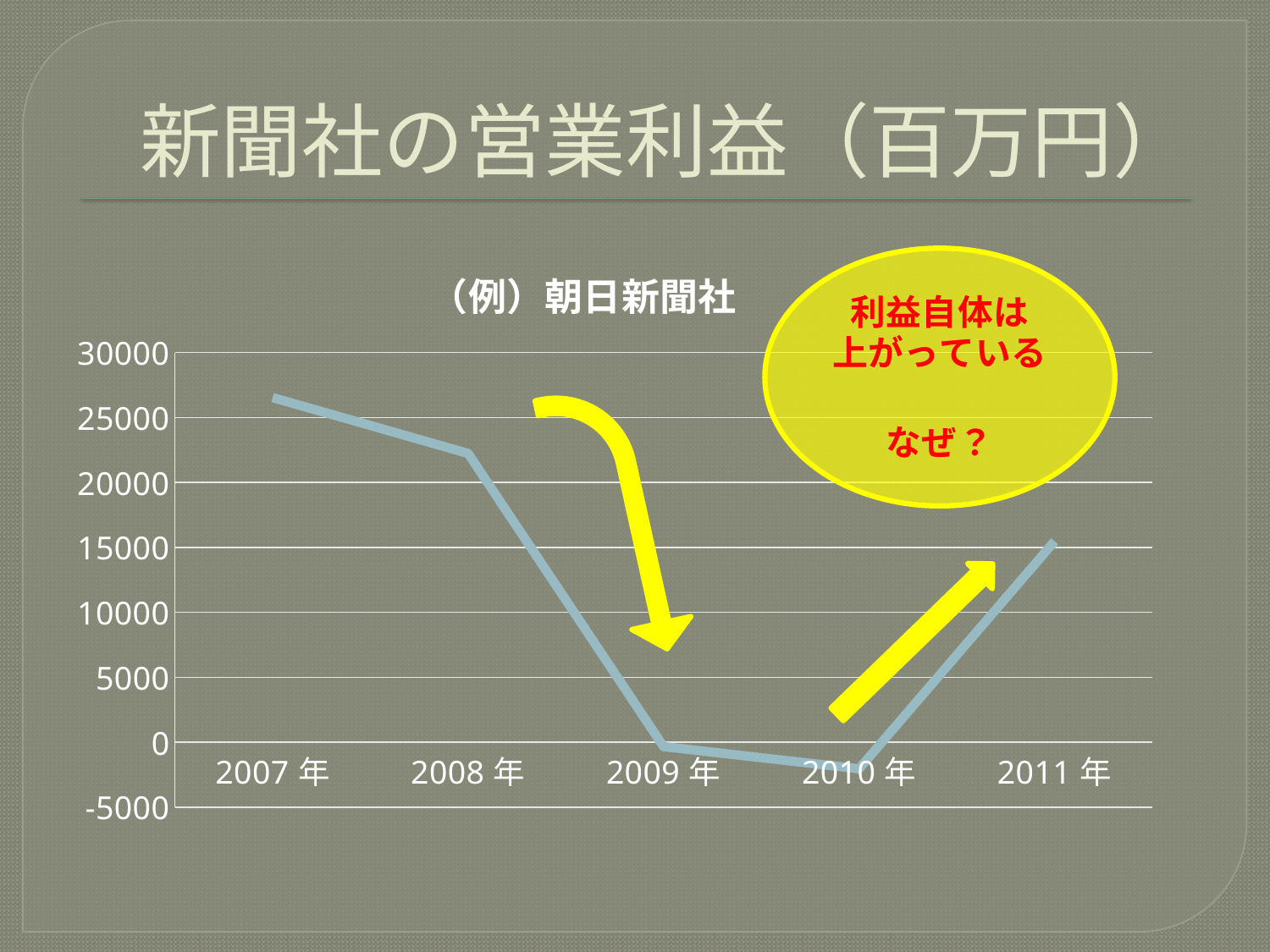
Is the value for 2011年 greater or less than 10000? greater Is the value for 2008年 greater or less than 20000? greater Which is larger, the value for 2007年 or the value for 2008年? 2007年 Which year has the highest operating profit in the chart? 2007年 Is the value for 2009年 greater or less than 5000? less What is the title of the chart? （例）朝日新聞社 What kind of chart is shown on the slide? line chart Which is larger, the value for 2010年 or the value for 2011年? 2011年 How many years are plotted on the x axis of the chart? 5